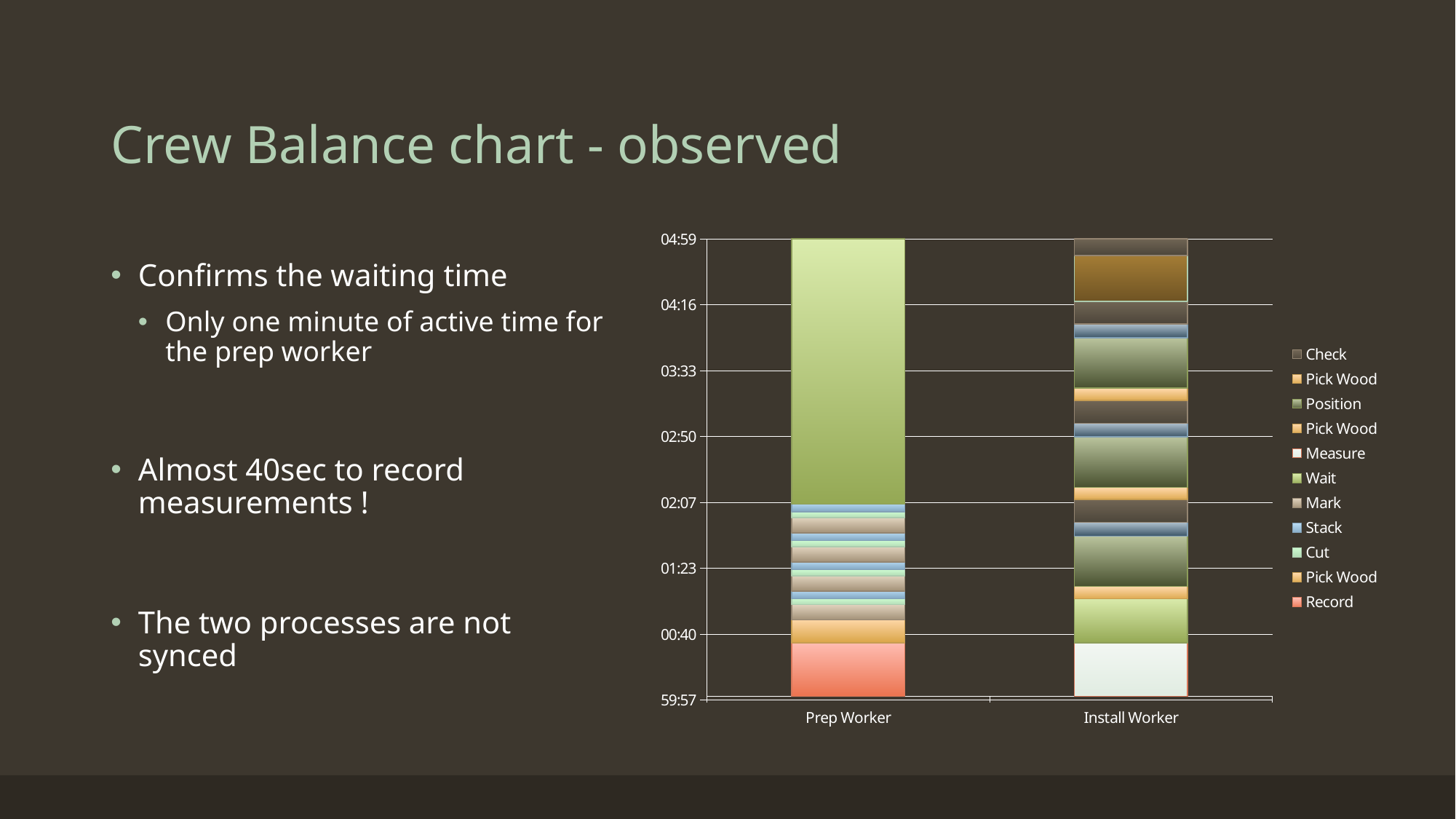
Which category's bar contains the large Wait segment? Prep Worker How many series does the chart's legend list? 11 What kind of chart is shown on the slide? Stacked bar chart Which category has the larger Wait segment, Prep Worker or Install Worker? Prep Worker What are the two categories on the x axis of the chart? Prep Worker and Install Worker How many categories are shown on the x axis of the chart? 2 Which series forms the bottom segment of the Prep Worker bar? Record